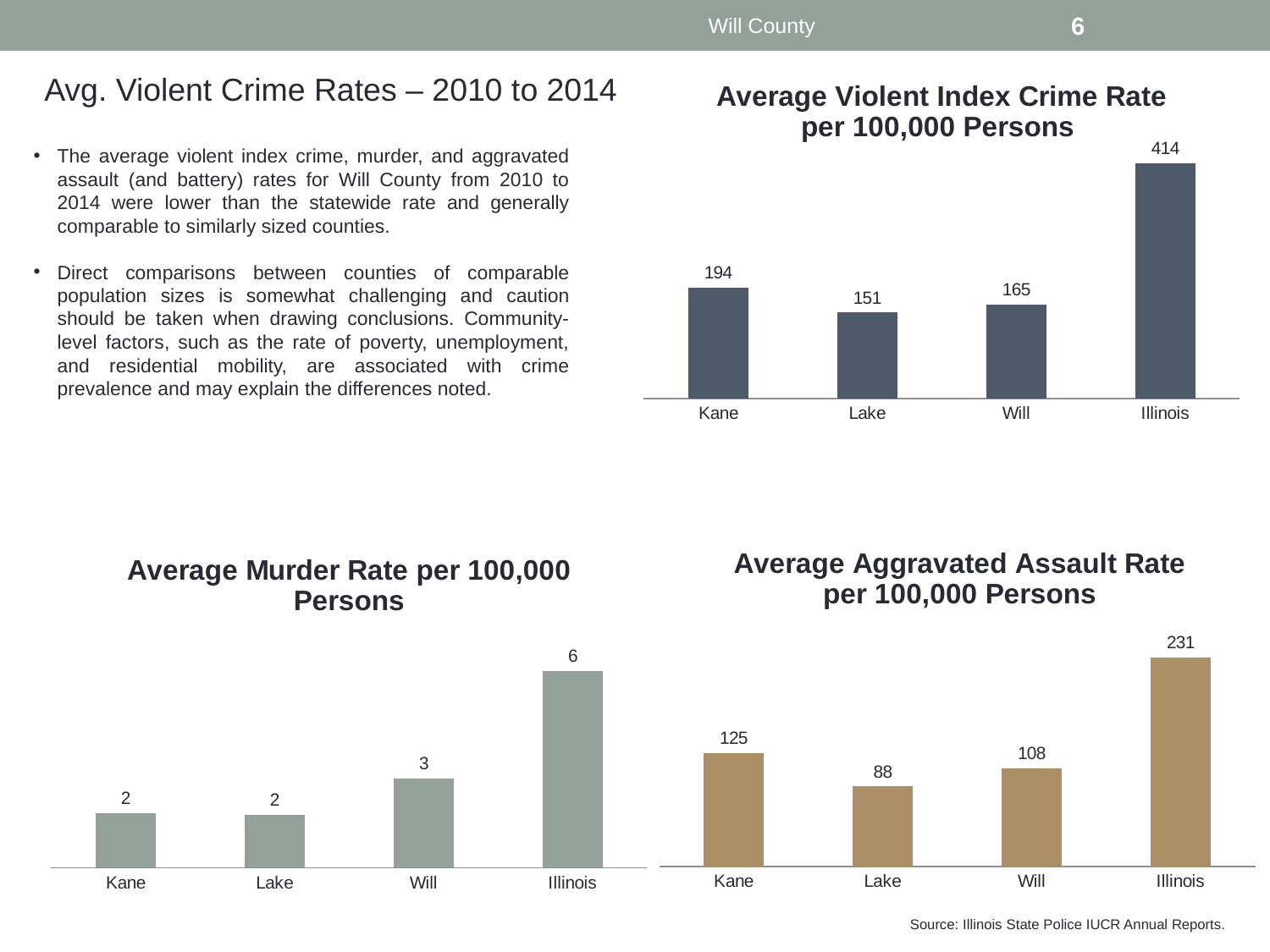
In the 'Average Murder Rate per 100,000 Persons' chart, what is the difference between the values for Will and Kane? 1 In the 'Average Aggravated Assault Rate per 100,000 Persons' chart, what is the value for Lake? 88 In the 'Average Violent Index Crime Rate per 100,000 Persons' chart, which category has the highest value? Illinois How many charts are shown on the slide? 3 In the 'Average Aggravated Assault Rate per 100,000 Persons' chart, what is the difference between the values for Illinois and Lake? 143 In the 'Average Murder Rate per 100,000 Persons' chart, how many categories are shown on the x axis? 4 What kind of chart is the 'Average Aggravated Assault Rate per 100,000 Persons' chart? Bar chart In the 'Average Violent Index Crime Rate per 100,000 Persons' chart, which category has the lowest value? Lake In the 'Average Murder Rate per 100,000 Persons' chart, what is the value for Illinois? 6 In the 'Average Violent Index Crime Rate per 100,000 Persons' chart, what is the difference between the values for Illinois and Kane? 220 In the 'Average Violent Index Crime Rate per 100,000 Persons' chart, what is the value for Will? 165 In the 'Average Aggravated Assault Rate per 100,000 Persons' chart, which is larger, the value for Kane or the value for Will? Kane